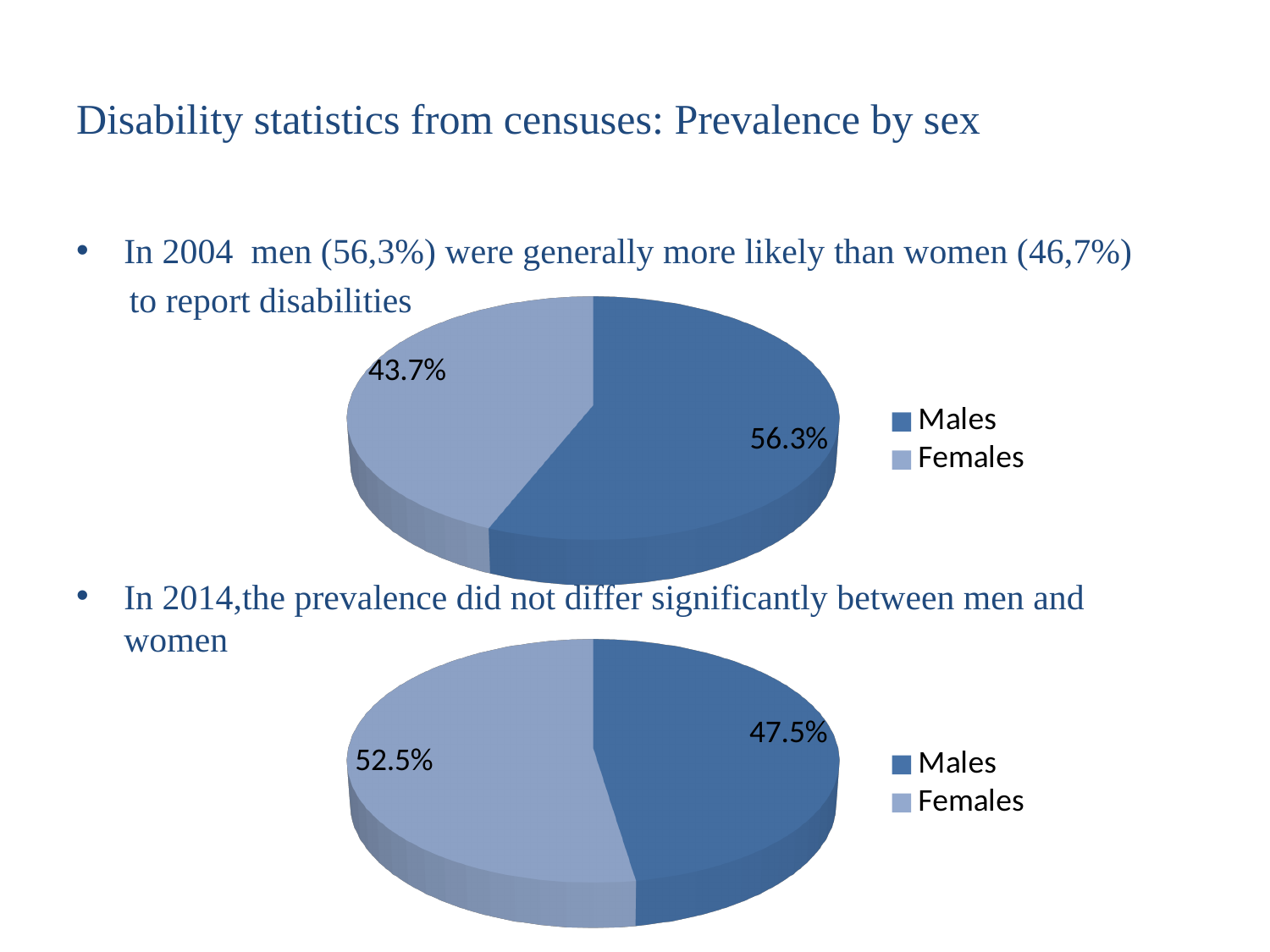
In the bottom pie chart, what is the value for Males? 47.5% In the top pie chart, what is the value for Males? 56.3% In the top pie chart, what is the value for Females? 43.7% In the top pie chart, what is the difference between the Males and Females values? 12.6% What kind of chart is the top chart on the slide? Pie chart In the bottom pie chart, which category has the smaller share? Males How many categories does the legend of the bottom pie chart list? 2 In the bottom pie chart, is the value for Males or Females larger? Females In the bottom pie chart, what is the value for Females? 52.5% In the top pie chart, which colour represents Females? Light blue In the top pie chart, which category has the larger share? Males In the bottom pie chart, what is the difference between the Females and Males values? 5%